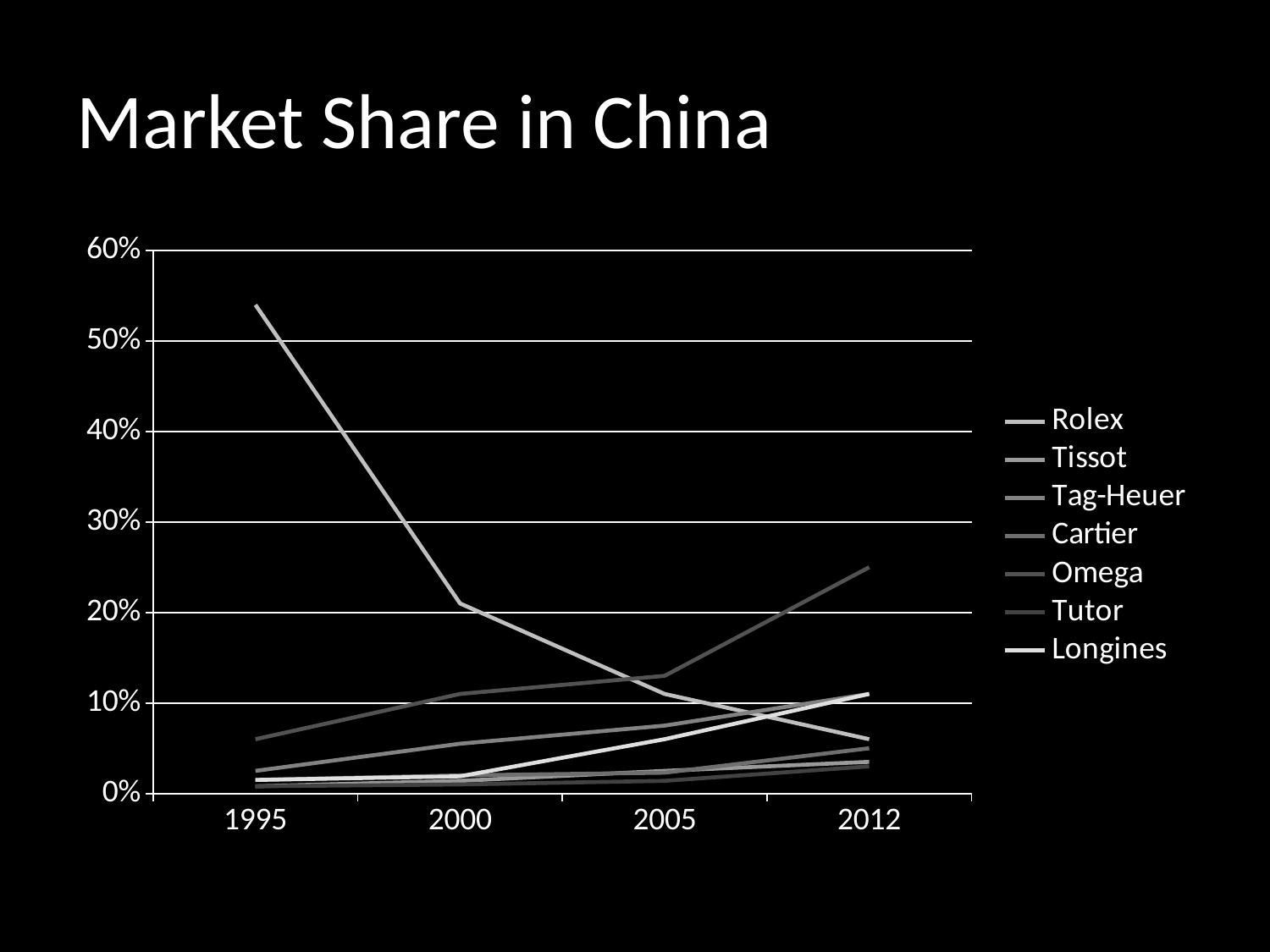
Is the highest value plotted in 2012 greater or less than 30%? less Does the line that starts highest in 1995 rise or fall between 1995 and 2005? fall How many years are shown on the x axis? 4 Is the highest value plotted in 2005 greater or less than 10%? greater What kind of chart is shown on the slide? line chart Is the highest value plotted in 2000 greater or less than 30%? less In which year does any series reach its highest value on the chart? 1995 Which series is listed first in the legend? Rolex How many series does the legend list? 7 What is the title of the chart? Market Share in China